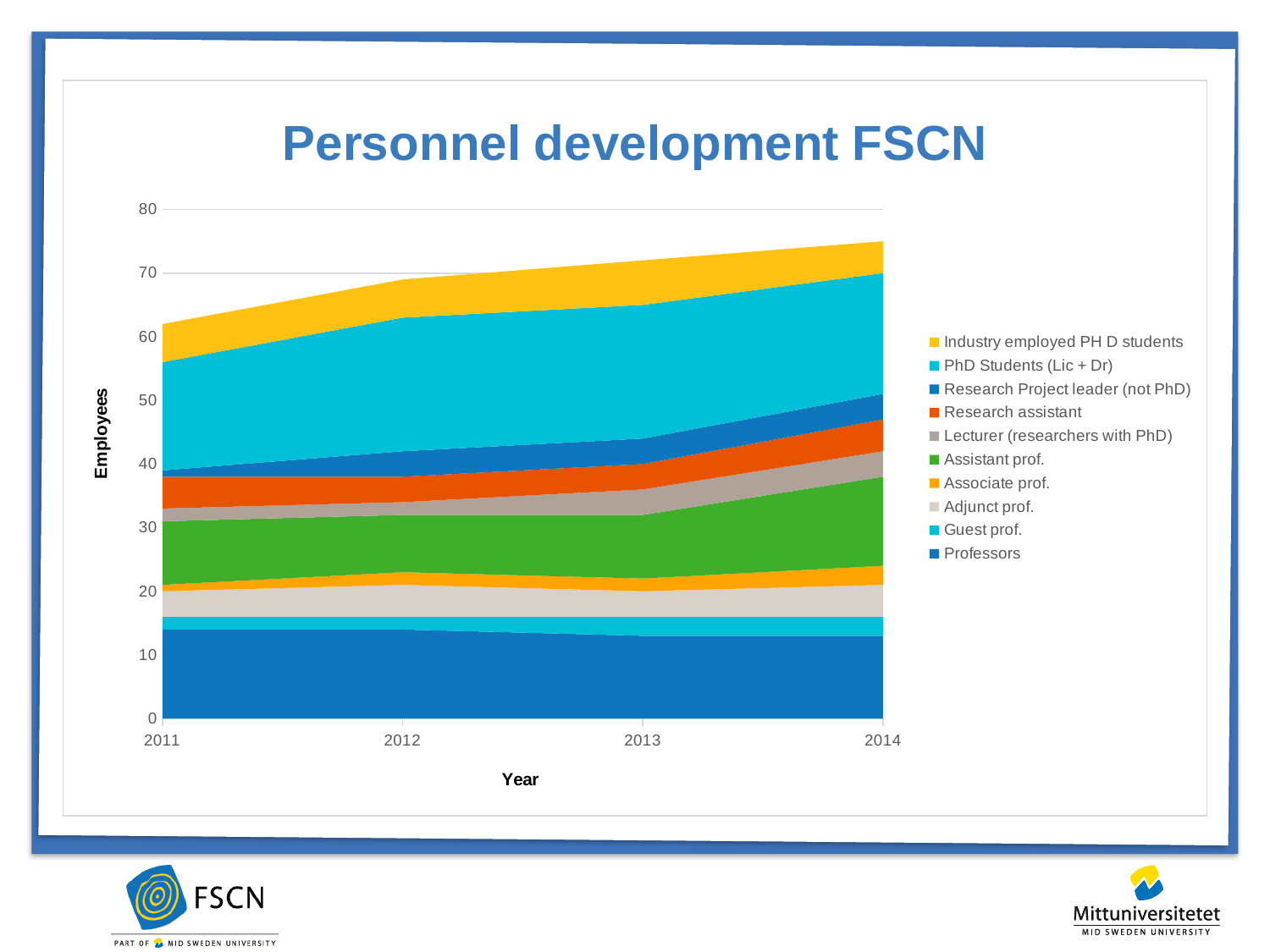
How many series does the legend of the chart list? 10 Is the total number of employees in 2011 greater or less than 60? greater Does the total number of employees rise or fall from 2011 to 2014? Rises How many years are shown along the x axis of the chart? 4 Which year has the lowest total number of employees? 2011 Is the total number of employees in 2011 greater or less than 70? less What is the label of the vertical axis of the chart? Employees Is the number of Professors in 2011 greater or less than 20? less What is the title of the chart? Personnel development FSCN What kind of chart is shown on the slide? Stacked area chart Which year has the highest total number of employees? 2014